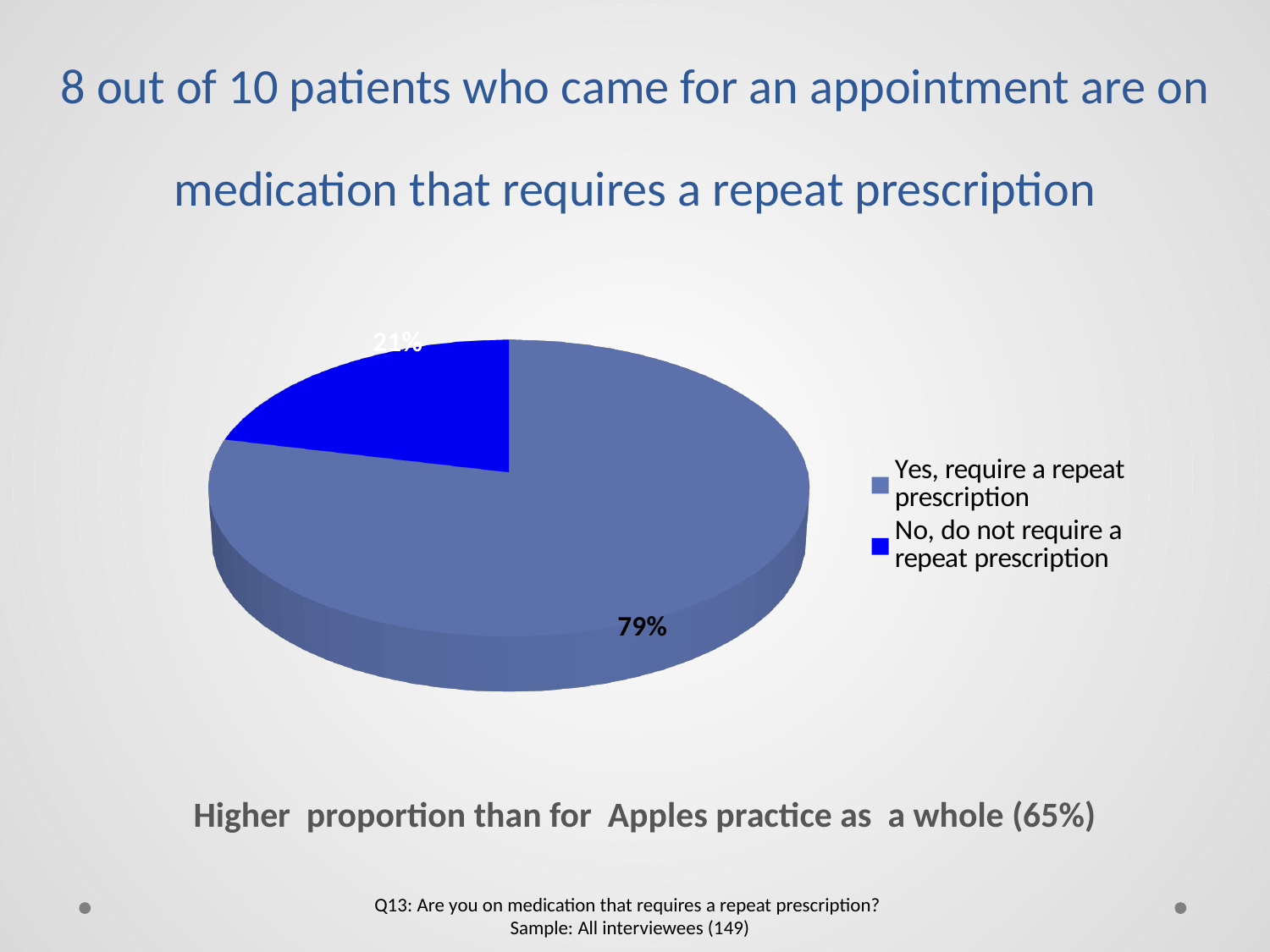
What kind of chart is shown on the slide? pie chart Which slice of the pie is the smallest? No, do not require a repeat prescription What is the difference in percentage points between the "Yes, require a repeat prescription" slice and the "No, do not require a repeat prescription" slice? 58 percentage points Which slice of the pie is the largest? Yes, require a repeat prescription What colour is the "No, do not require a repeat prescription" slice? bright blue How many entries does the legend list? 2 What share of the pie is labelled "No, do not require a repeat prescription"? 21% How many slices does the pie chart have? 2 According to the text below the chart, what is the proportion for the Apples practice as a whole? 65% What share of the pie is labelled "Yes, require a repeat prescription"? 79% Which is larger: the share for "Yes, require a repeat prescription" or the share for "No, do not require a repeat prescription"? Yes, require a repeat prescription